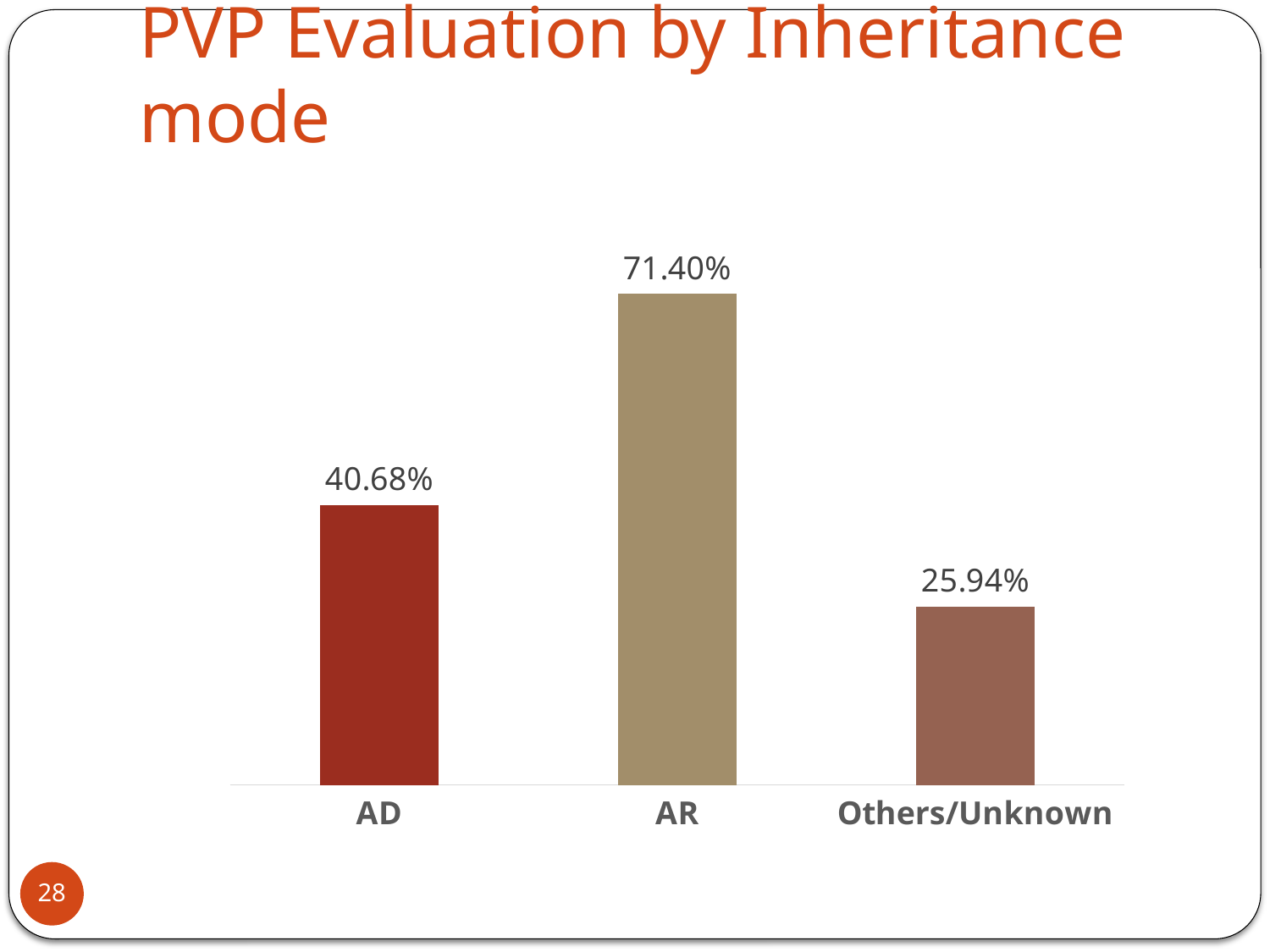
What is the value for AD? 40.68% How many categories are shown on the x axis? 3 Which is larger, the value for AD or the value for Others/Unknown? AD Which category has the highest value? AR Which category has the lowest value? Others/Unknown What kind of chart is shown on the slide? bar chart What is the value for Others/Unknown? 25.94% What is the difference between the values for AR and AD? 30.72% What is the title of the slide containing the chart? PVP Evaluation by Inheritance mode What colour is the bar for AD? dark red What is the value for AR? 71.40% What is the difference between the values for AD and Others/Unknown? 14.74%